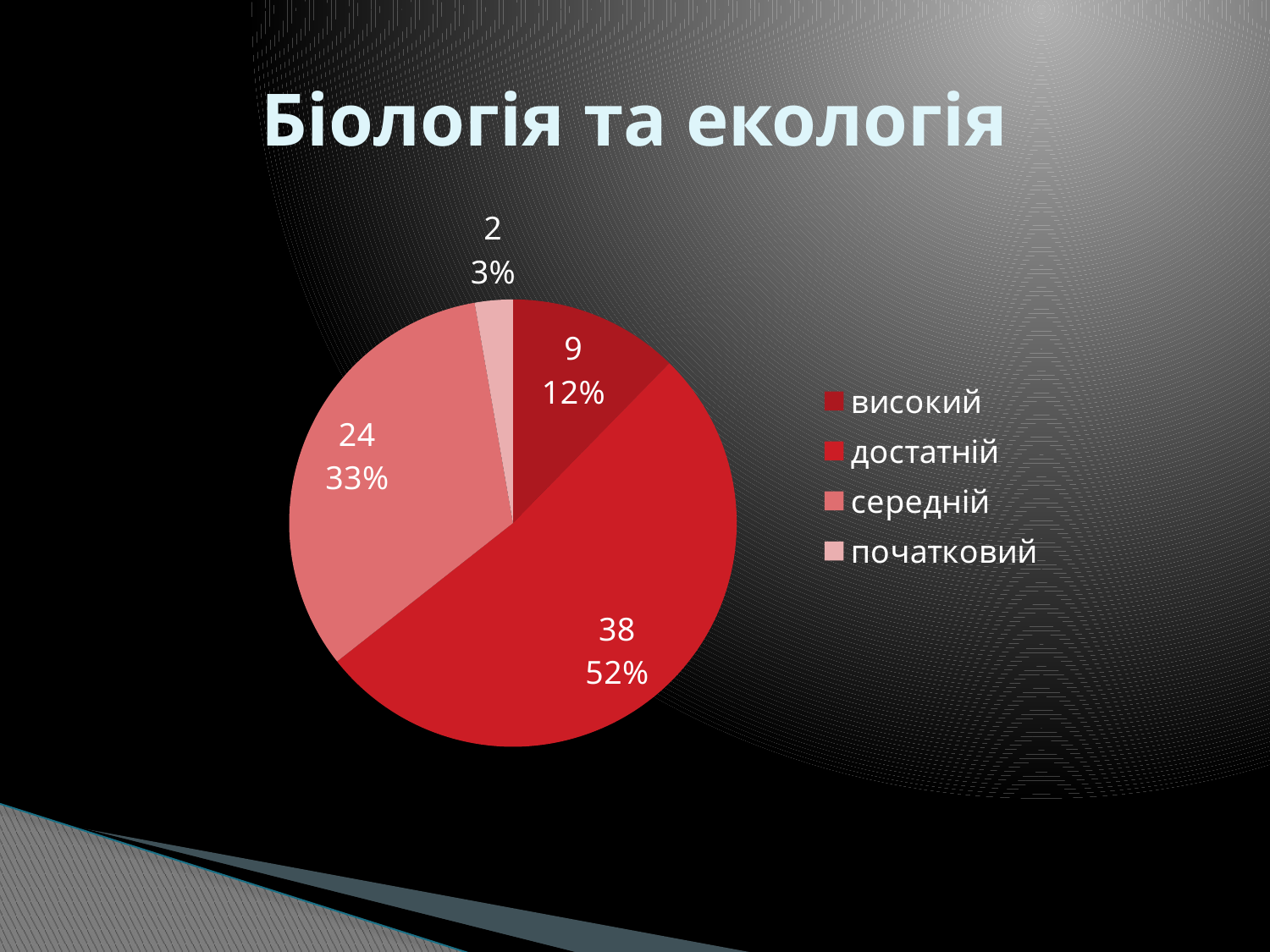
What is the value for достатній? 38 Which category has the smallest slice? початковий What is the value for початковий? 2 How many categories does the legend list? 4 What is the value for середній? 24 Which is larger, the value for високий or the value for середній? середній What share of the pie does середній take? 33% What is the value for високий? 9 What is the difference between the values for достатній and середній? 14 Which category has the largest slice? достатній What kind of chart is shown on the slide? pie chart What share of the pie does високий take? 12%